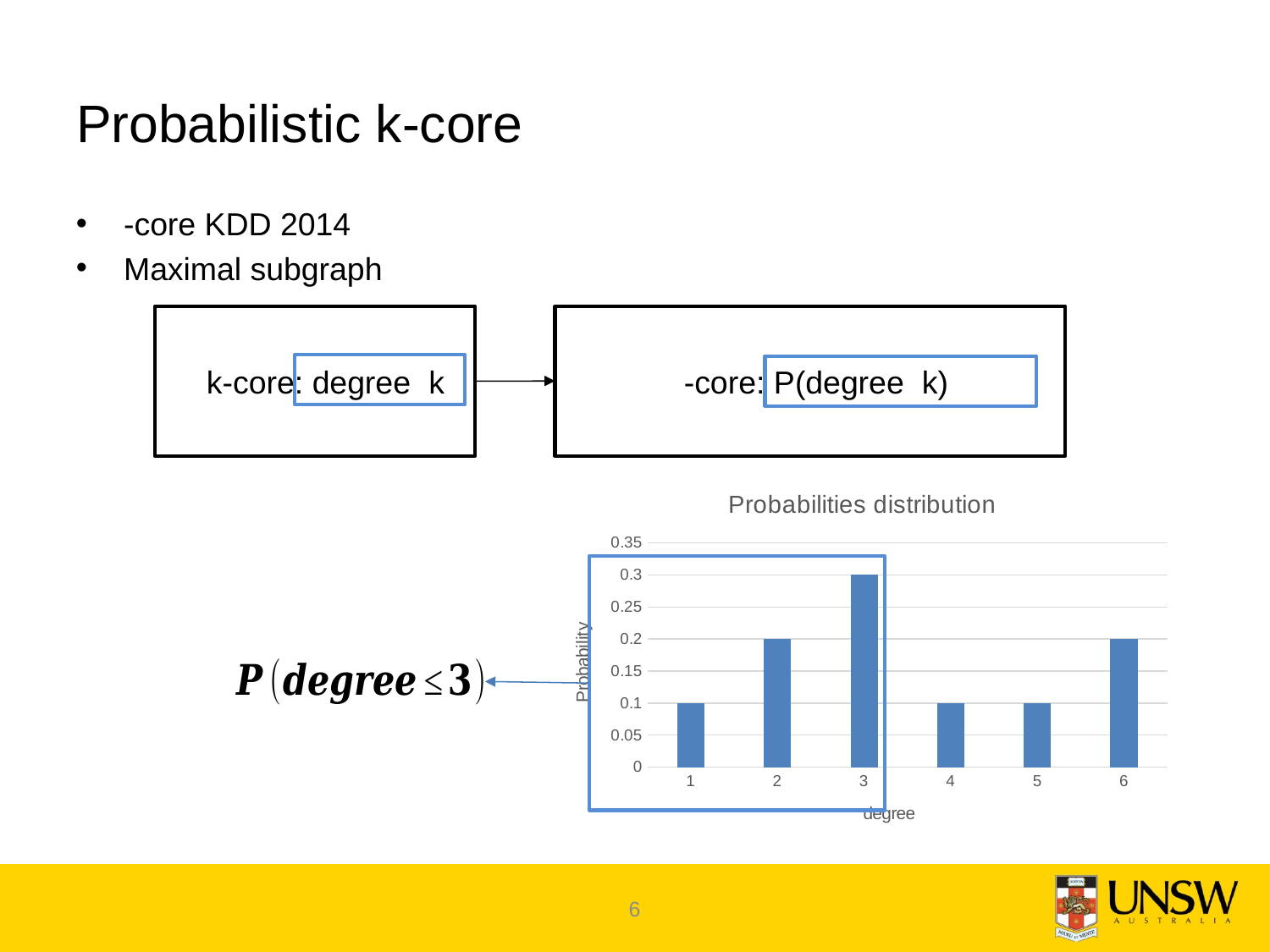
What is the title of the chart? Probabilities distribution Which has a higher probability in the chart, degree 3 or degree 4? degree 3 How many degree categories are plotted on the x axis of the chart? 6 What type of chart is shown on the slide? bar chart What is the probability for degree 3 in the chart? 0.3 What is the probability for degree 2 in the chart? 0.2 Is the probability for degree 6 greater or less than 0.15? greater What is the probability for degree 1 in the chart? 0.1 Which degree has the highest probability in the chart? 3 What is the probability for degree 6 in the chart? 0.2 What is the difference between the probability for degree 3 and the probability for degree 1? 0.2 What is the label of the y axis of the chart? Probability